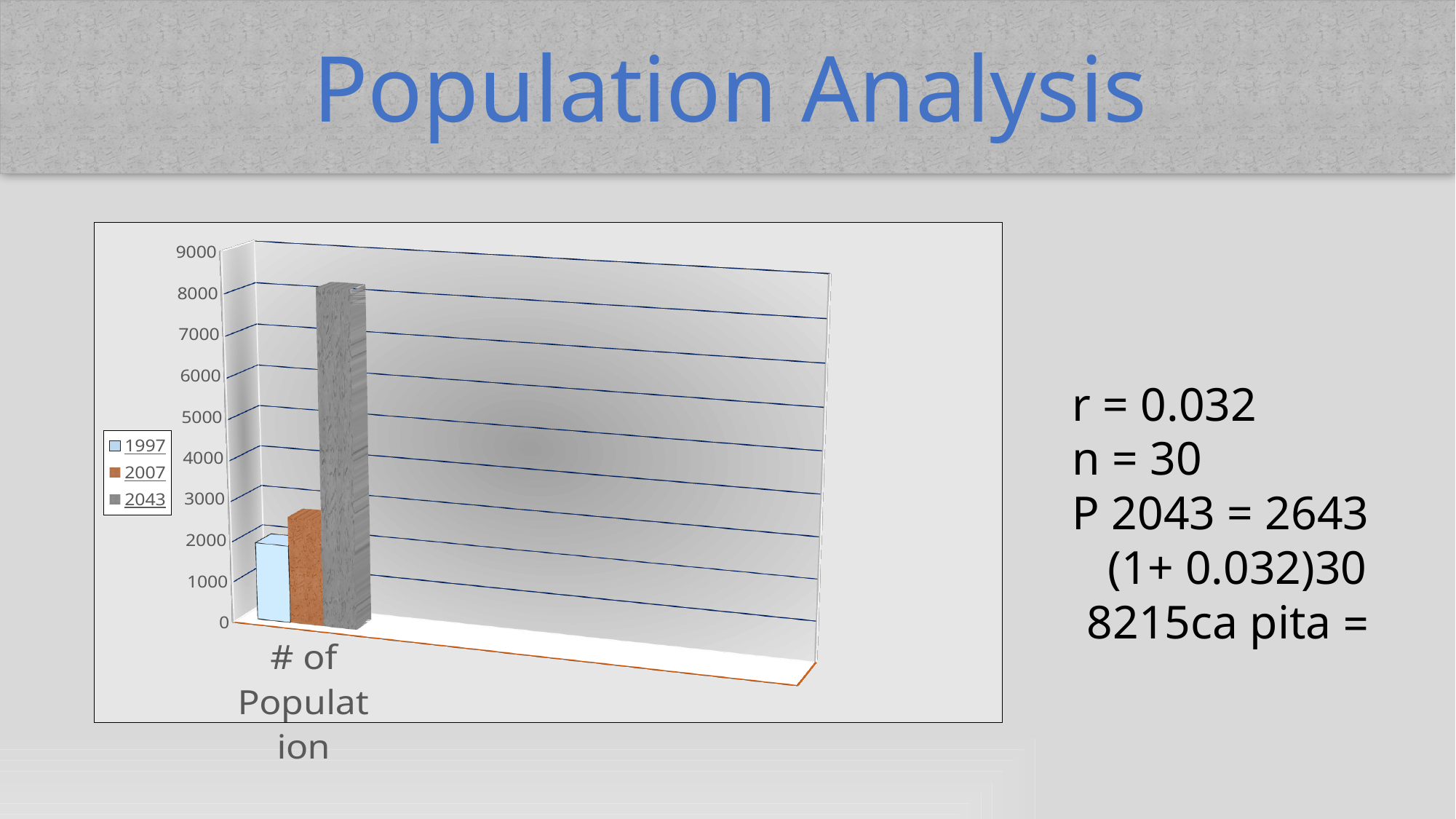
Which series has the highest value for # of Population? 2043 Which series has the lowest value for # of Population? 1997 How many categories are shown on the x axis of the chart? 1 Is the value for 2043 greater or less than 9000? less What kind of chart is shown on the slide? bar chart What is the label of the category on the x axis? # of Population Which is larger, the value for 2043 or the value for 2007? 2043 Is the value for 1997 greater or less than 1000? greater Is the value for 2007 greater or less than 4000? less How many series does the chart legend list? 3 Which is larger, the value for 2007 or the value for 1997? 2007